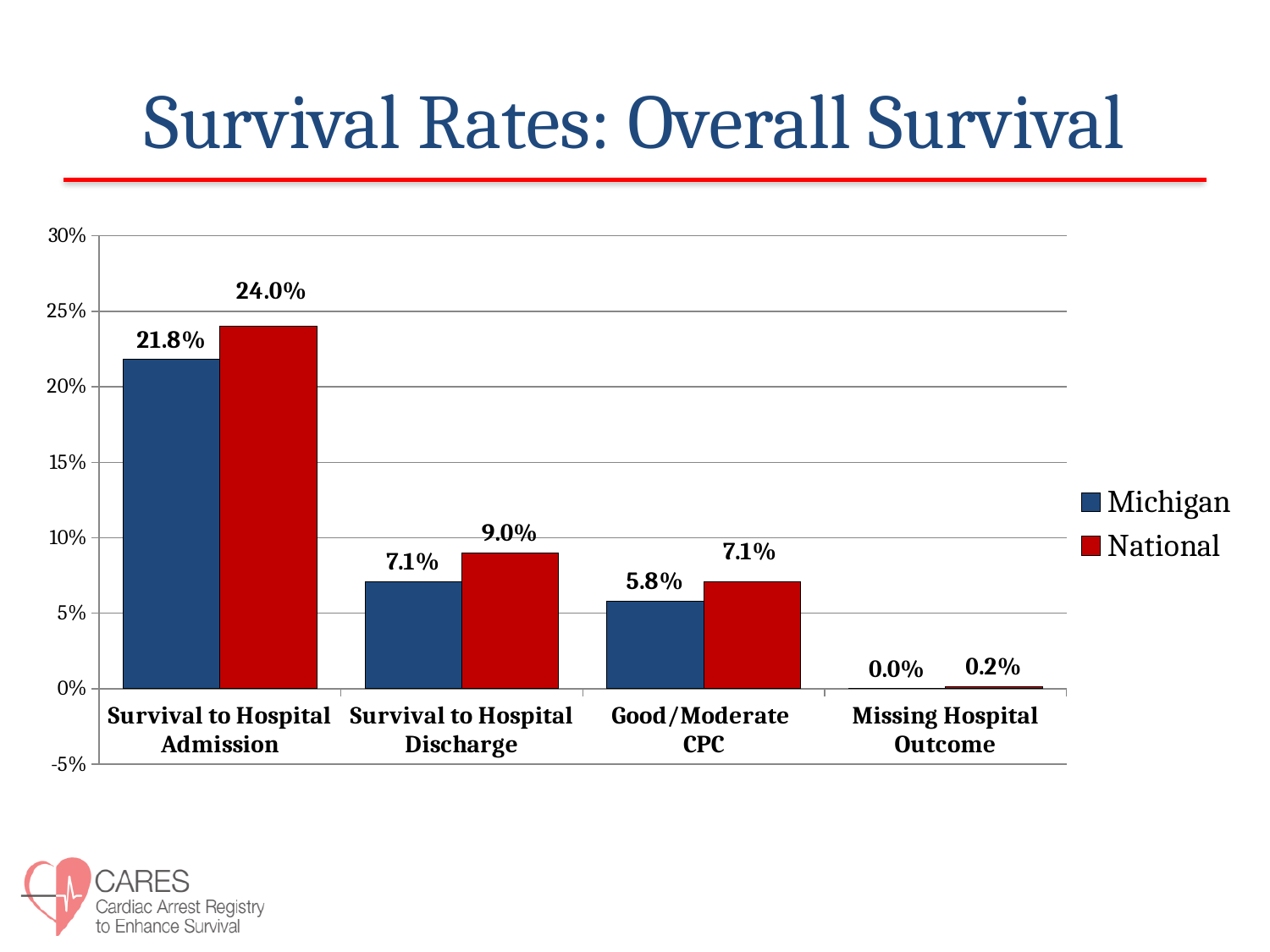
Which is larger for Survival to Hospital Discharge, the Michigan value or the National value? National What is the difference between the National and Michigan values for Survival to Hospital Admission? 2.2% What kind of chart is shown on the slide? Bar chart What is the Michigan value for Good/Moderate CPC? 5.8% What is the National value for Survival to Hospital Discharge? 9.0% Which category has the lowest Michigan value? Missing Hospital Outcome How many series does the legend list? 2 How many categories are shown on the x axis? 4 What is the National value for Missing Hospital Outcome? 0.2% Which category has the highest National value? Survival to Hospital Admission Is the Michigan value for Survival to Hospital Admission greater or less than 20%? greater What is the Michigan value for Survival to Hospital Admission? 21.8%